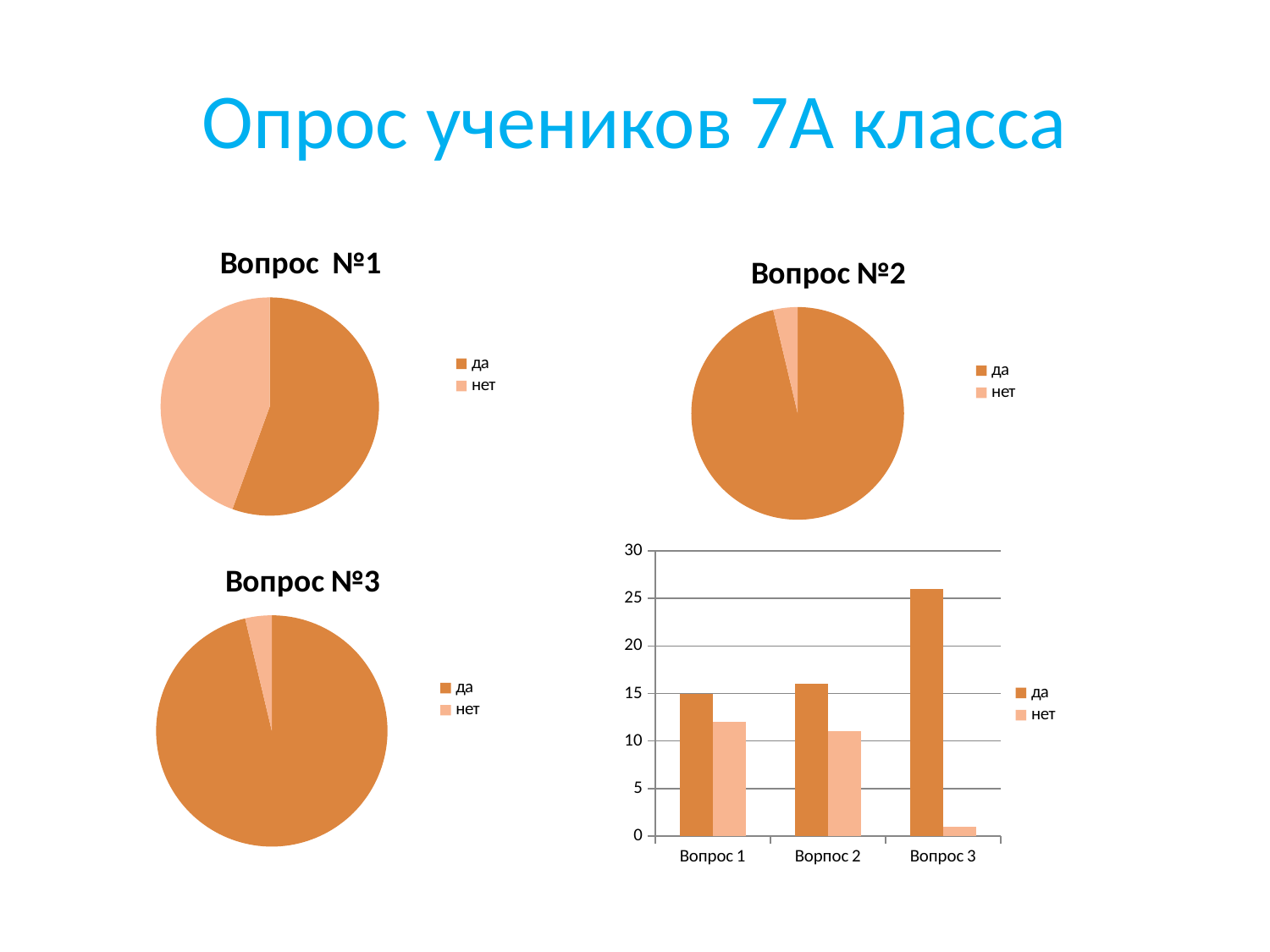
In the bottom-right bar chart, is the "нет" value for Вопрос 2 greater or less than 15? less In the chart titled "Вопрос №3", which slice is the largest? да In the chart titled "Вопрос №2", which slice is the smallest? нет What are the two legend entries in the chart titled "Вопрос №2"? да, нет In the bottom-right bar chart, which category has the highest "да" bar? Вопрос 3 In the chart titled "Вопрос №1", which slice is larger, "да" or "нет"? да How many categories are shown on the x axis of the bottom-right bar chart? 3 In the bottom-right bar chart, which category has the lowest "нет" bar? Вопрос 3 What kind of chart is the chart titled "Вопрос №1"? pie chart What kind of chart is the chart in the bottom right of the slide? bar chart In the bottom-right bar chart, is the "да" value for Вопрос 3 greater or less than 25? greater How many series does the legend of the bottom-right bar chart list? 2